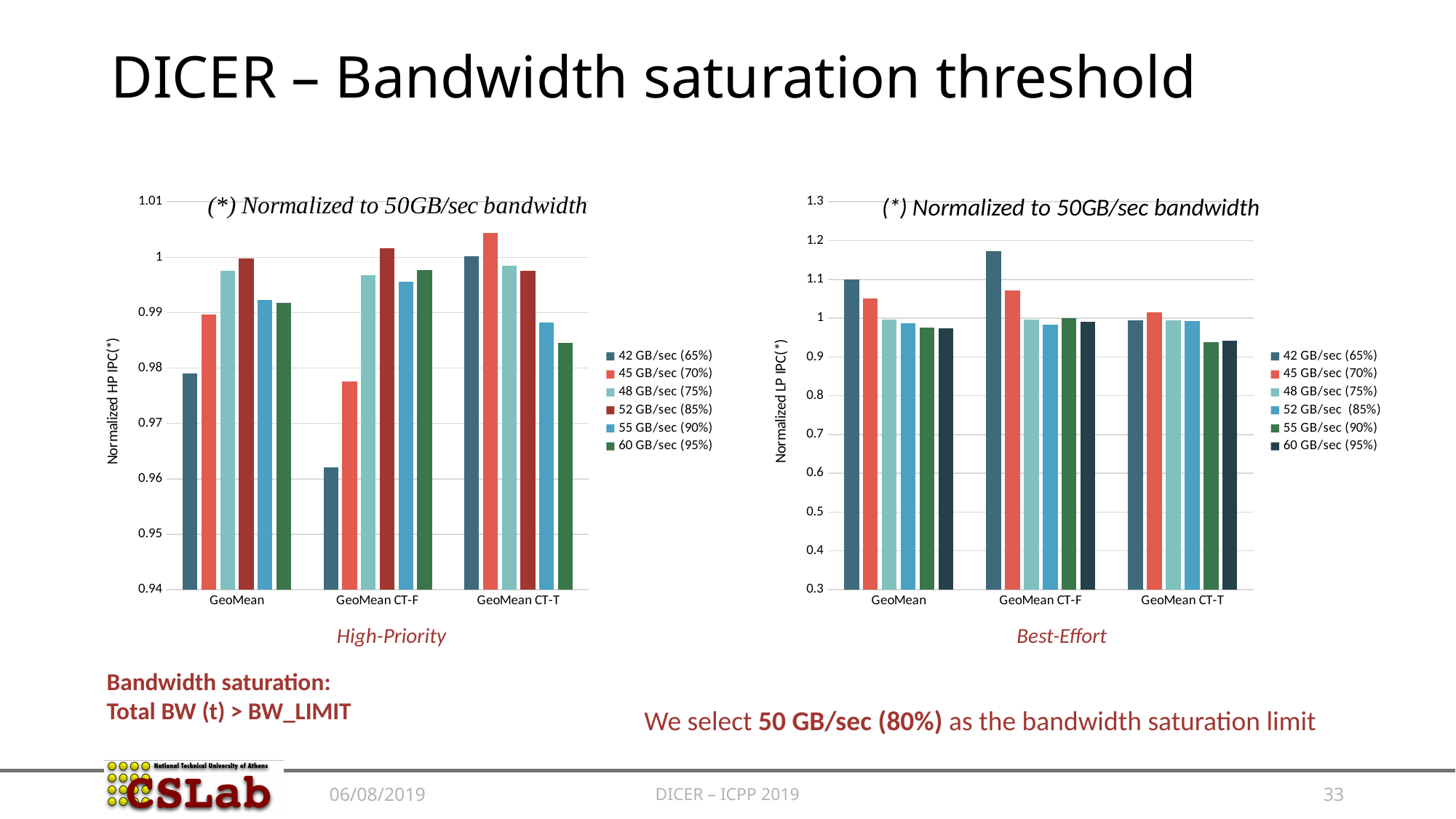
What is the y-axis label of the High-Priority chart? Normalized HP IPC(*) What is the y-axis label of the Best-Effort chart? Normalized LP IPC(*) What kind of chart is the High-Priority chart on the left? bar chart In the High-Priority chart, is the value for 45 GB/sec (70%) at GeoMean CT-T greater or less than 1? greater In the High-Priority chart, which category has the lowest bar for 42 GB/sec (65%)? GeoMean CT-F In the Best-Effort chart, is the value for 42 GB/sec (65%) at GeoMean CT-F greater or less than 1.1? greater In the Best-Effort chart, at GeoMean CT-F, which is larger: the 42 GB/sec (65%) bar or the 45 GB/sec (70%) bar? 42 GB/sec (65%) In the Best-Effort chart, which category has the highest bar for 42 GB/sec (65%)? GeoMean CT-F How many series does the legend of the Best-Effort chart list? 6 How many categories are shown on the x axis of the High-Priority chart? 3 In the High-Priority chart, is the value for 42 GB/sec (65%) at GeoMean CT-F greater or less than 0.97? less